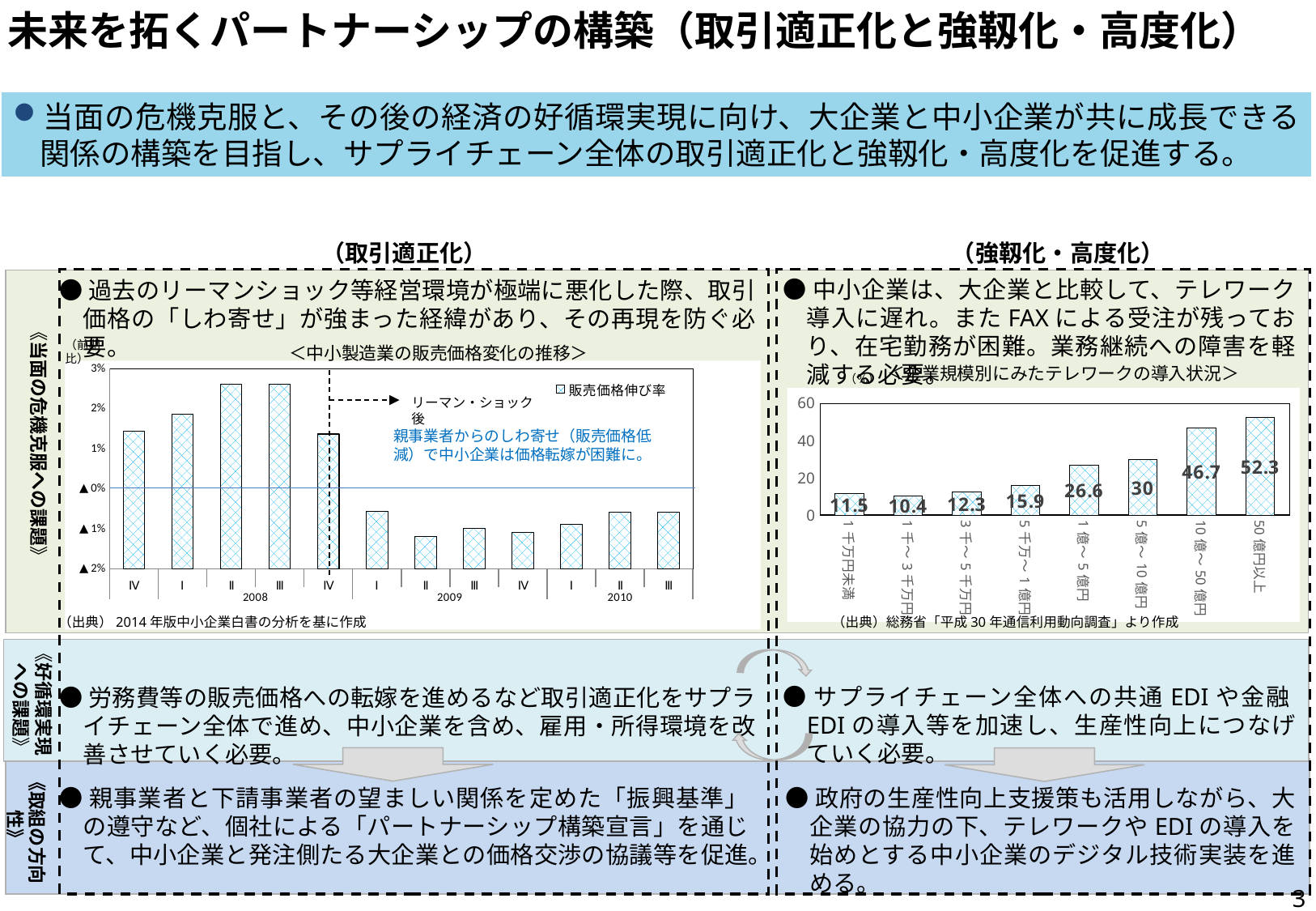
In the chart titled 企業規模別にみたテレワークの導入状況, what is the value for 50億円以上? 52.3 In the chart titled 企業規模別にみたテレワークの導入状況, which category has the highest value? 50億円以上 How many categories are shown in the chart titled 企業規模別にみたテレワークの導入状況? 8 In the chart titled 企業規模別にみたテレワークの導入状況, what is the value for 1億～5億円? 26.6 In the chart titled 企業規模別にみたテレワークの導入状況, do the values generally rise or fall as company size increases along the x axis? rise In the chart titled 企業規模別にみたテレワークの導入状況, what is the value for 5億～10億円? 30 In the chart titled 企業規模別にみたテレワークの導入状況, which is larger: the value for 5千万～1億円 or the value for 3千～5千万円? 5千万～1億円 In the chart titled 中小製造業の販売価格変化の推移, is the value for quarter II of 2008 greater or less than 2%? greater How many series does the legend list in the chart titled 中小製造業の販売価格変化の推移? 1 What kind of chart is the chart titled 中小製造業の販売価格変化の推移? bar chart In the chart titled 企業規模別にみたテレワークの導入状況, which category has the lowest value? 1千～3千万円 In the chart titled 企業規模別にみたテレワークの導入状況, what is the difference between the values for 50億円以上 and 10億～50億円? 5.6